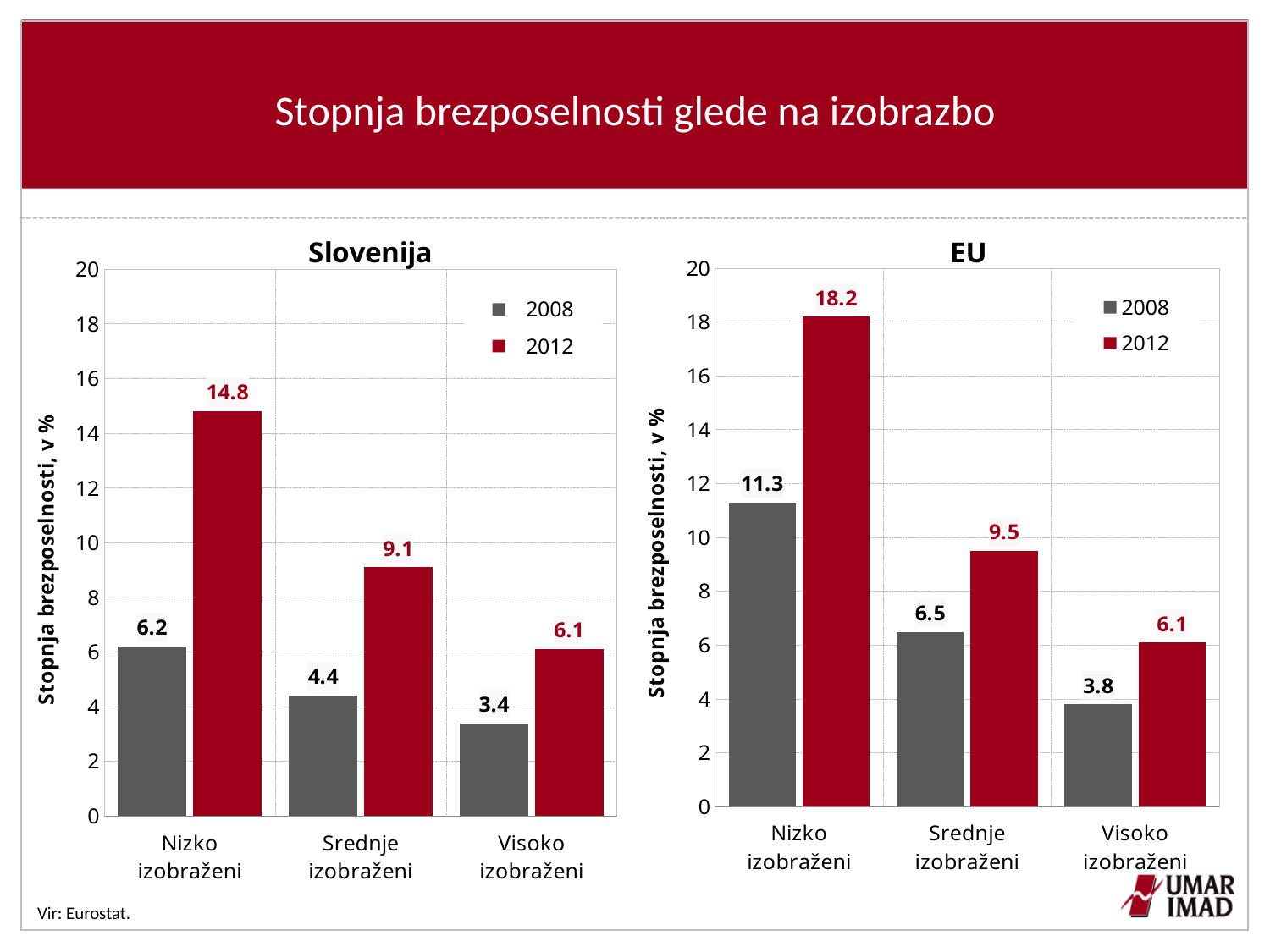
In the EU chart, which category has the highest 2012 value? Nizko izobraženi Which is larger: the 2012 value for Nizko izobraženi in the Slovenija chart or in the EU chart? EU In the Slovenija chart, which category has the lowest 2008 value? Visoko izobraženi In the EU chart, what is the difference between the 2012 and 2008 values for Nizko izobraženi? 6.9 In the Slovenija chart, what is the 2012 value for Nizko izobraženi? 14.8 What kind of chart is the Slovenija chart? Bar chart How many series does the legend of the EU chart list? 2 In the Slovenija chart, what is the difference between the 2012 and 2008 values for Srednje izobraženi? 4.7 In the Slovenija chart, what is the 2008 value for Visoko izobraženi? 3.4 How many categories are shown on the x axis of the Slovenija chart? 3 In the EU chart, what is the 2008 value for Srednje izobraženi? 6.5 In the EU chart, is the 2008 value for Nizko izobraženi greater or less than 10? greater